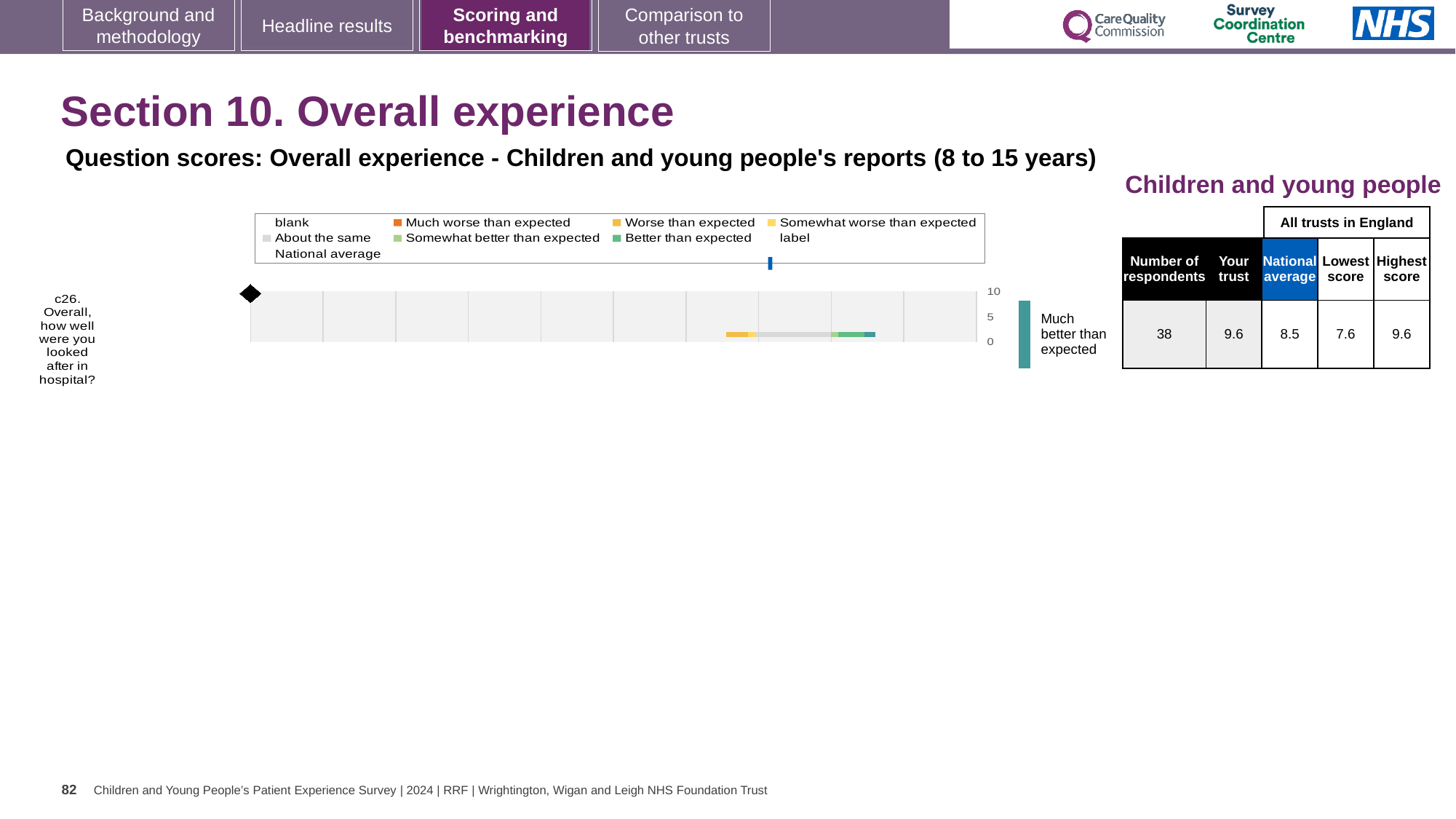
Which question is plotted in the chart? c26. Overall, how well were you looked after in hospital? What is the difference between the 'Your trust' score and the National average for question c26? 1.1 How many survey questions are plotted in the chart? 1 What is the highest value shown on the chart's axis? 10 What kind of chart is shown on the slide? bar chart In the table, what is the National average score for question c26? 8.5 How many respondents answered question c26? 38 In the table, what is the 'Your trust' score for question c26? 9.6 In the table, what is the Lowest score among all trusts in England for question c26? 7.6 What rating category is shown next to the chart for question c26? Much better than expected Which is larger for question c26, the 'Your trust' score or the National average? Your trust In the table, what is the Highest score among all trusts in England for question c26? 9.6